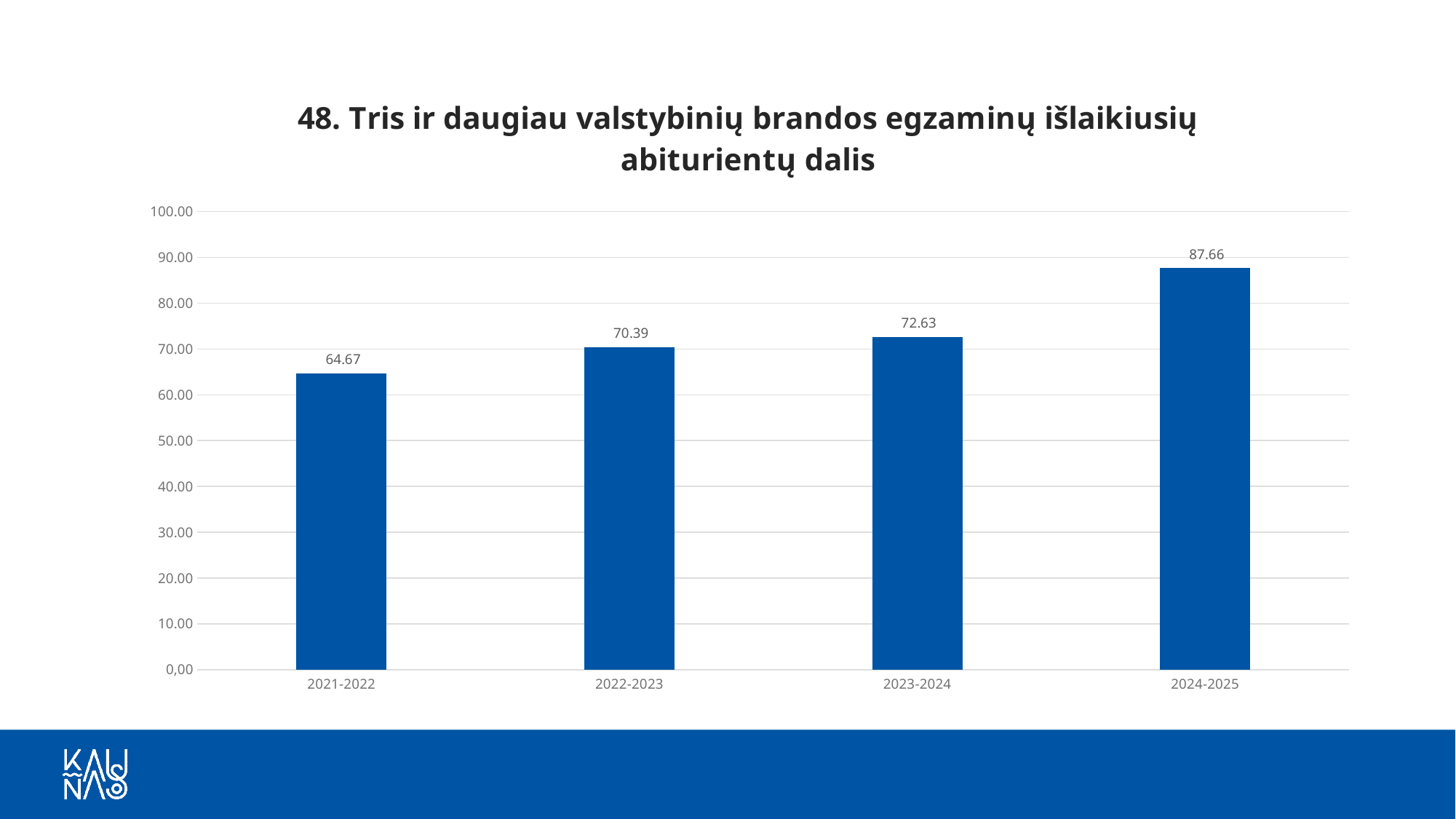
What is the difference between the values for 2023-2024 and 2022-2023? 2.24 Which is larger, the value for 2022-2023 or the value for 2024-2025? 2024-2025 Which school year has the highest value? 2024-2025 What kind of chart is shown on the slide? bar chart What is the value for 2021-2022? 64.67 What is the value for 2022-2023? 70.39 Which school year has the lowest value? 2021-2022 What is the difference between the values for 2024-2025 and 2021-2022? 22.99 Do the values rise or fall from 2021-2022 to 2024-2025? rise What is the value for 2023-2024? 72.63 How many school years are shown on the chart? 4 What is the value for 2024-2025? 87.66